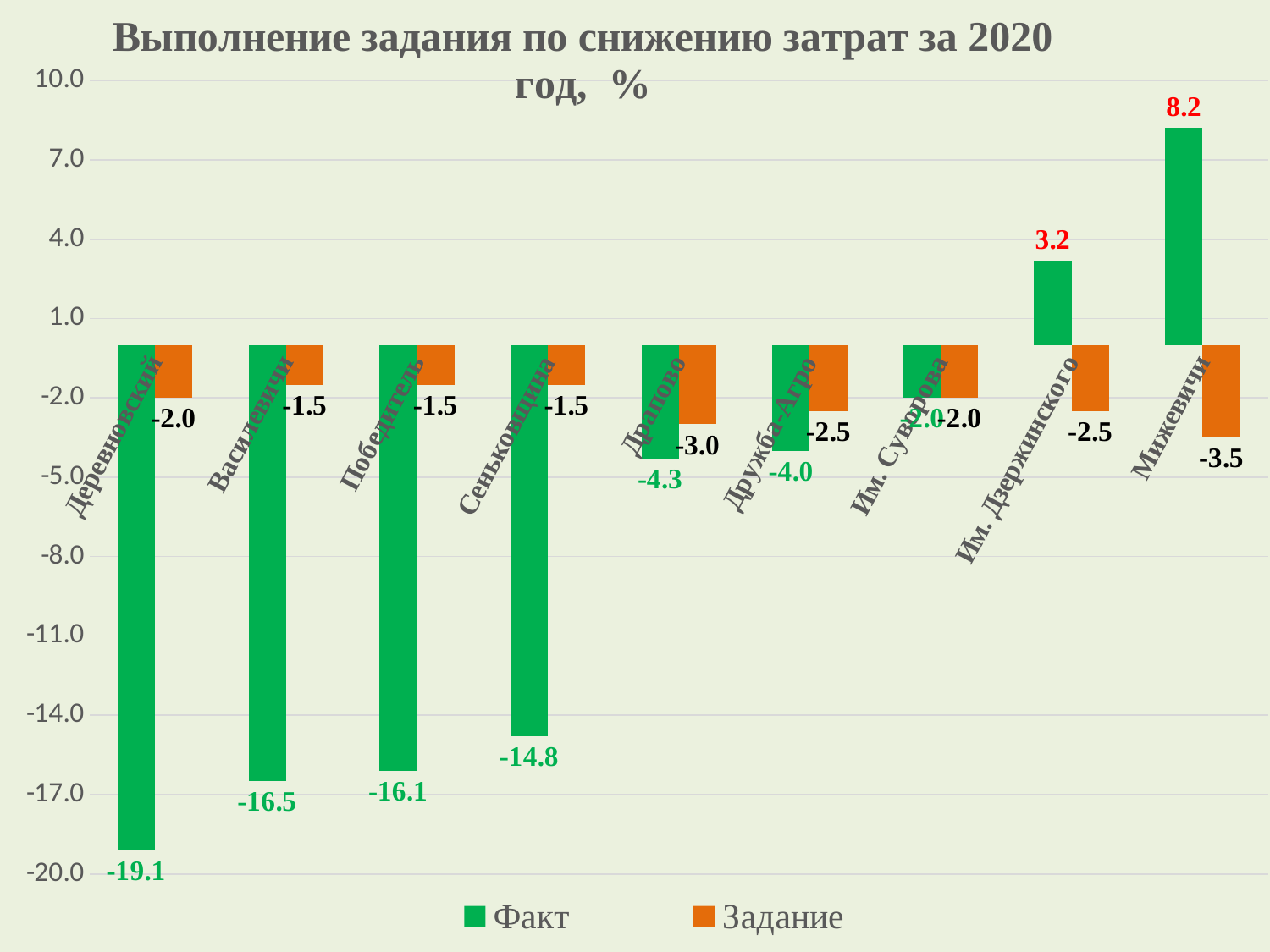
What is the Задание value for Драпово? -3.0 How many series does the legend list? 2 What is the Факт value for Деревновский? -19.1 What is the Задание value for Мижевичи? -3.5 What is the difference between the Факт values for Василевичи and Победитель? 0.4 Which colour represents the Задание series? Orange Which category has the highest Факт value? Мижевичи Which category has the lowest Факт value? Деревновский What is the Факт value for Им. Дзержинского? 3.2 Which is larger, the Факт value for Драпово or the Факт value for Дружба-Агро? Дружба-Агро What kind of chart is shown on the slide? Bar chart How many categories are shown on the x axis? 9